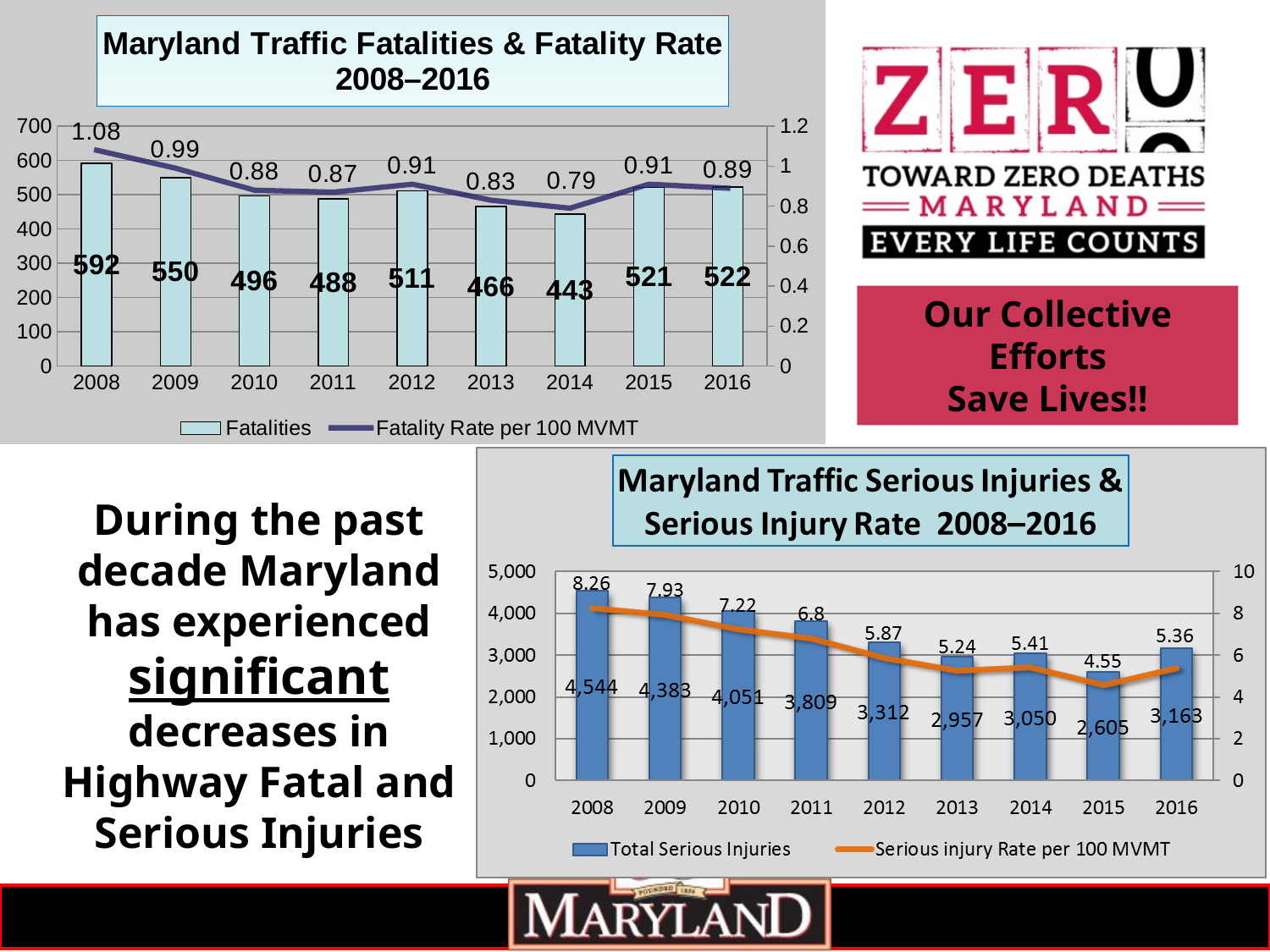
In the Maryland Traffic Serious Injuries & Serious Injury Rate chart, which year had the lowest number of total serious injuries? 2015 In the Maryland Traffic Fatalities & Fatality Rate chart, how many years are shown on the x axis? 9 In the Maryland Traffic Fatalities & Fatality Rate chart, what is the difference in fatalities between 2008 and 2016? 70 In the Maryland Traffic Serious Injuries & Serious Injury Rate chart, how many total serious injuries were there in 2015? 2,605 In the Maryland Traffic Fatalities & Fatality Rate chart, which year had the highest number of fatalities? 2008 In the Maryland Traffic Fatalities & Fatality Rate chart, which year had the lowest fatality rate per 100 MVMT? 2014 In the Maryland Traffic Serious Injuries & Serious Injury Rate chart, what is the overall trend of the serious injury rate from 2008 to 2016? Falling In the Maryland Traffic Serious Injuries & Serious Injury Rate chart, what was the serious injury rate per 100 MVMT in 2011? 6.8 In the Maryland Traffic Fatalities & Fatality Rate chart, what was the fatality rate per 100 MVMT in 2008? 1.08 In the Maryland Traffic Fatalities & Fatality Rate chart, how many series does the legend list? 2 In the Maryland Traffic Serious Injuries & Serious Injury Rate chart, were there more total serious injuries in 2014 or in 2016? 2016 In the Maryland Traffic Fatalities & Fatality Rate chart, how many fatalities were there in 2014? 443